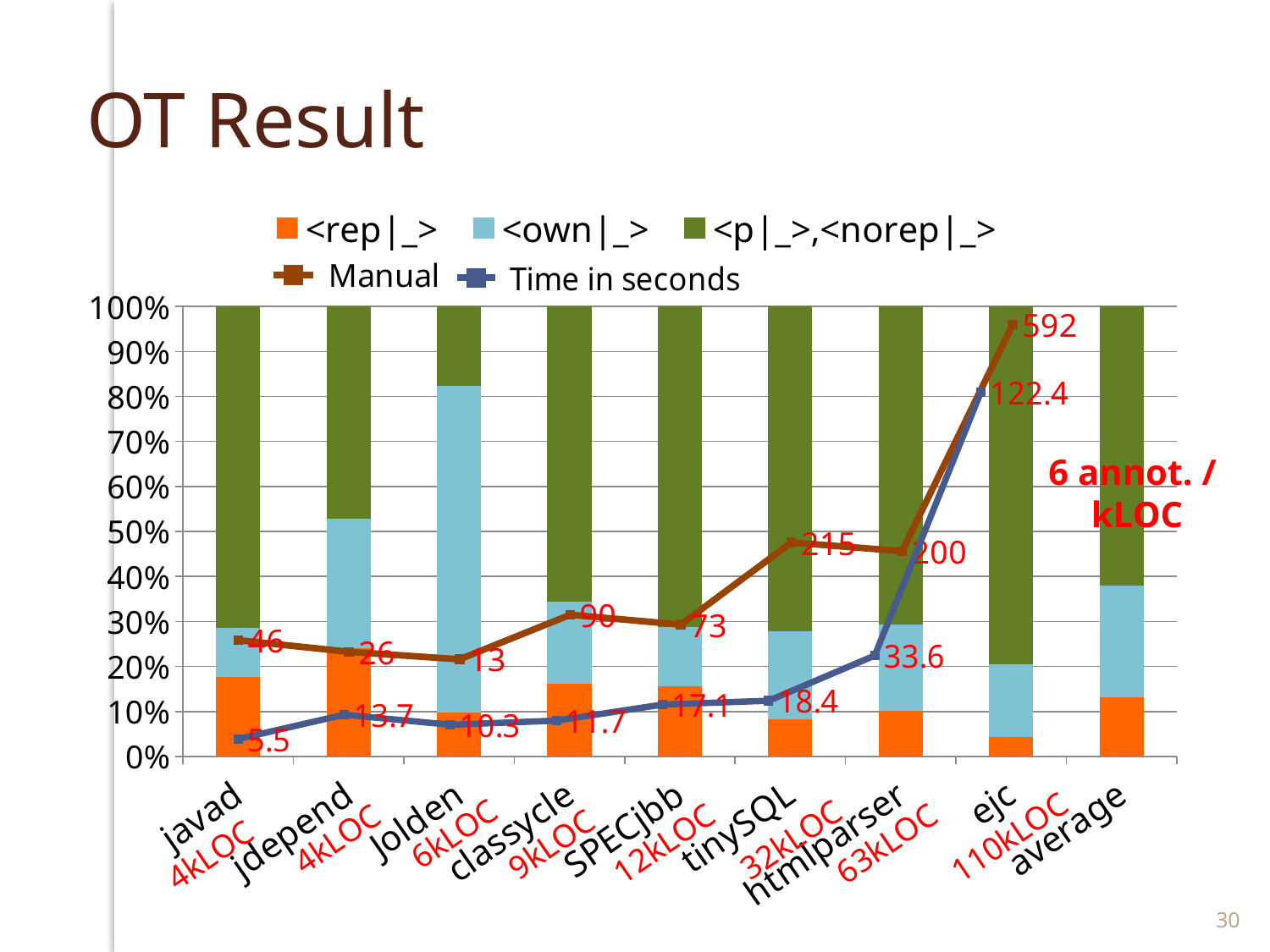
How many series does the legend list? 5 What is the difference between the Manual values for tinySQL and htmlparser? 15 Which program has the highest Manual value? ejc Which has a larger Manual value, SPECjbb or classycle? classycle What is the Manual value for classycle? 90 Is the <rep|_> share for javad greater or less than 10%? greater Which program has the lowest Time in seconds value? javad Which program has the lowest Manual value? Jolden What is the Manual value for ejc? 592 What is the Time in seconds value for javad? 5.5 How many categories are shown on the x axis? 9 What is the Time in seconds value for htmlparser? 33.6